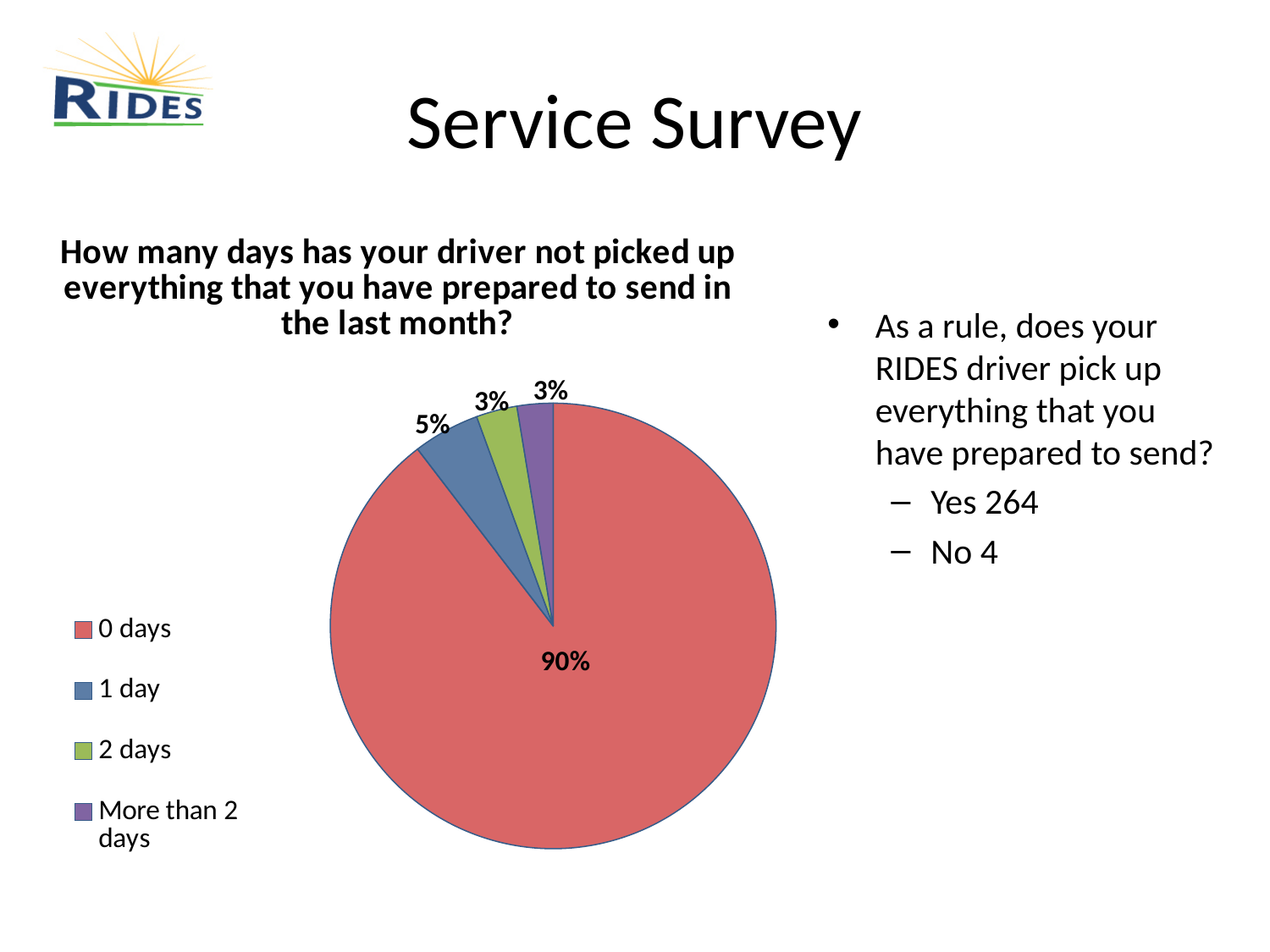
What share of the pie does the "0 days" slice represent? 90% How many slices does the pie chart have? 4 What share of the pie does the "2 days" slice represent? 3% What kind of chart is shown on the slide? Pie chart Which is larger, the share for "1 day" or the share for "2 days"? 1 day What share of the pie does the "More than 2 days" slice represent? 3% Which is larger, the share for "0 days" or the share for "1 day"? 0 days What is the difference between the share for "0 days" and the share for "1 day"? 85 percentage points Which category has the largest slice of the pie? 0 days What is the title of the pie chart? How many days has your driver not picked up everything that you have prepared to send in the last month? How many entries does the legend list? 4